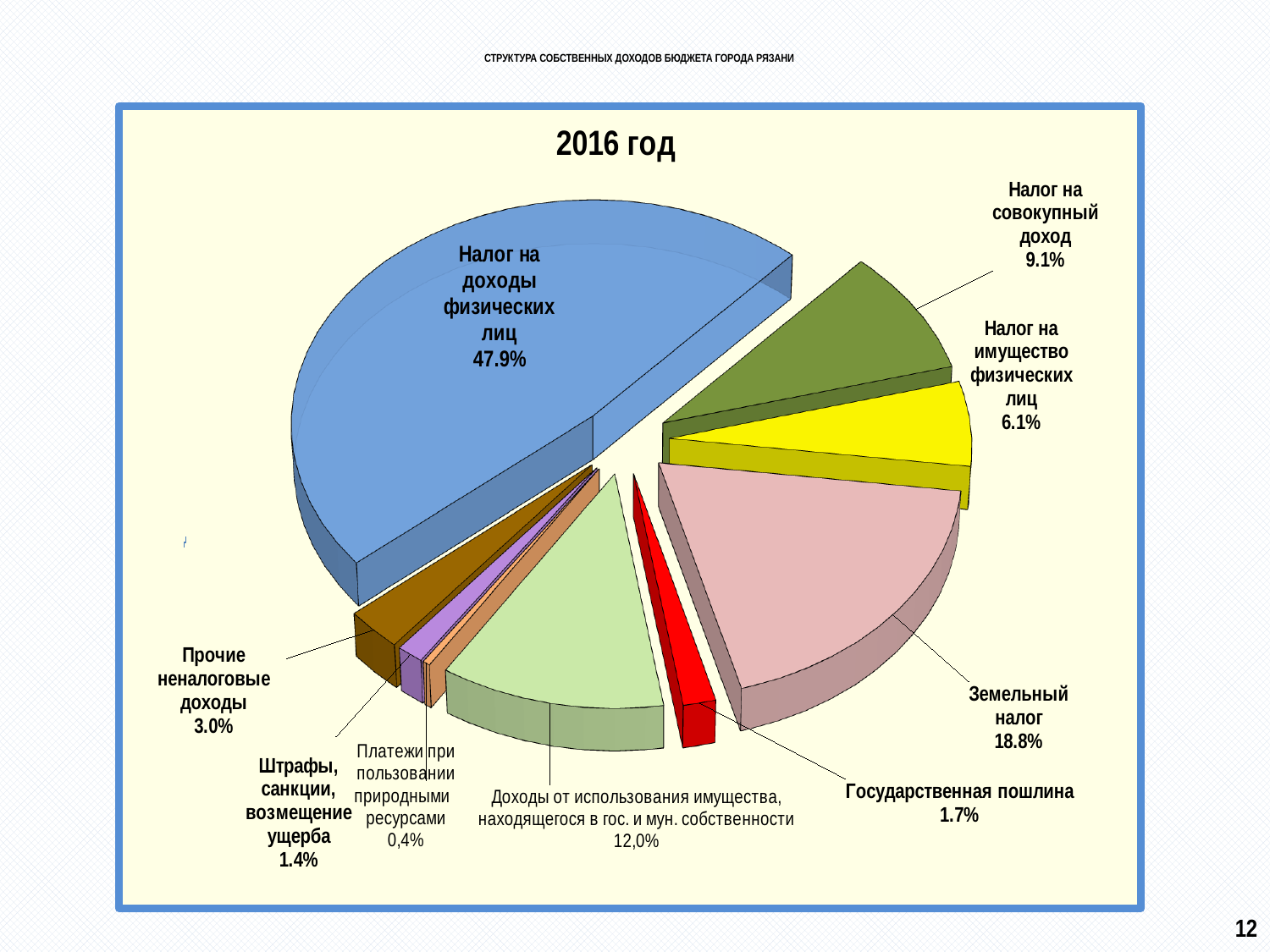
What is the share of "Доходы от использования имущества, находящегося в гос. и мун. собственности"? 12,0% What kind of chart is shown on the slide? pie chart Which is larger: "Прочие неналоговые доходы" or "Государственная пошлина"? Прочие неналоговые доходы Which category has the largest share of the pie? Налог на доходы физических лиц What year is shown in the chart title? 2016 год What is the share of "Налог на доходы физических лиц" in the pie chart? 47.9% What is the share of "Земельный налог" in the pie chart? 18.8% How many slices does the pie chart have? 9 What is the share of "Платежи при пользовании природными ресурсами"? 0,4% Which category has the smallest share of the pie? Платежи при пользовании природными ресурсами What is the share of "Налог на совокупный доход"? 9.1% What is the difference in percentage points between "Земельный налог" and "Налог на совокупный доход"? 9.7